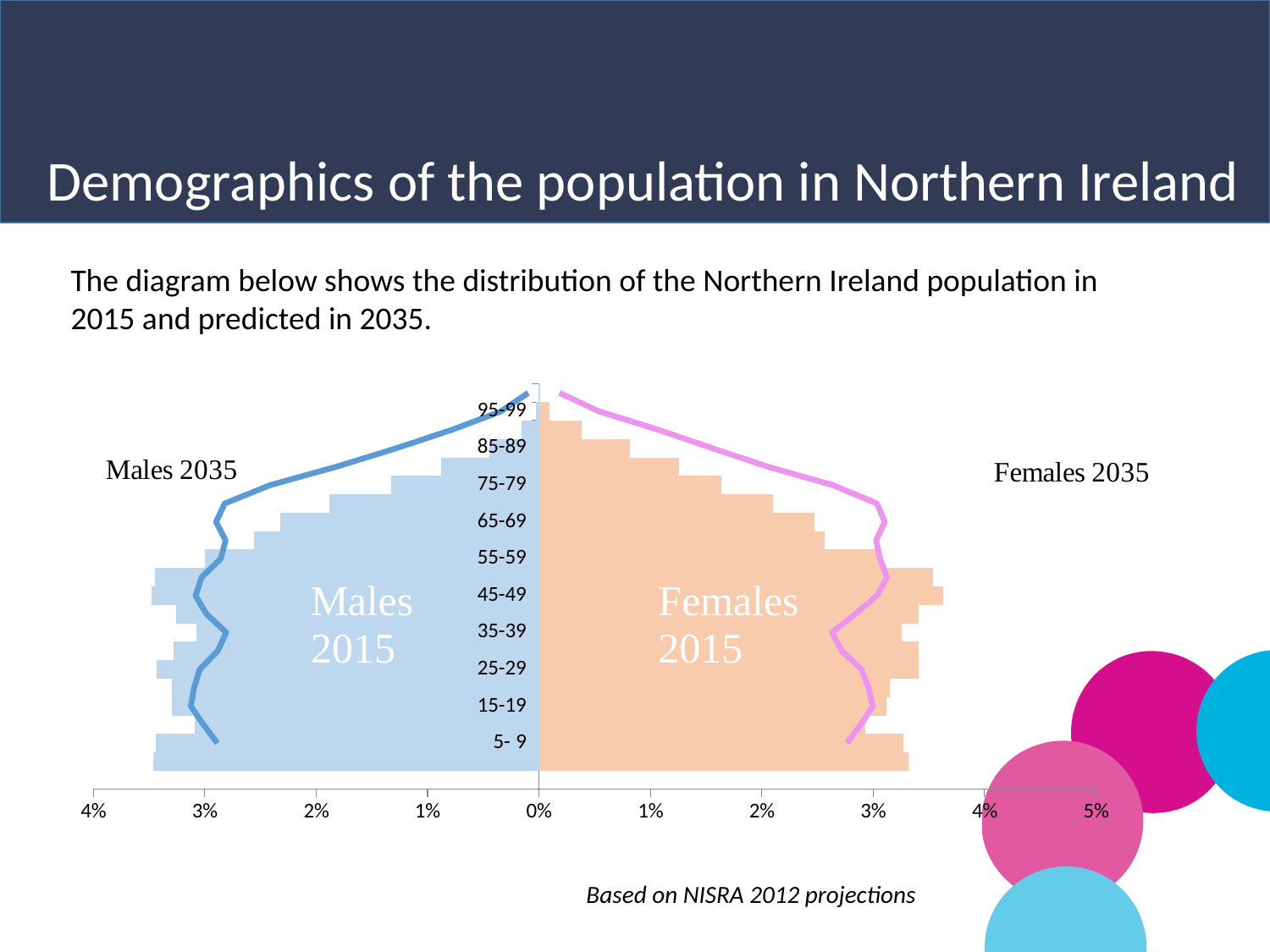
Is the Males 2015 value for the 45-49 age group greater or less than 3%? greater Is the Males 2015 value for the 85-89 age group greater or less than 1%? less What is the highest percentage tick shown on the right (female) side of the horizontal axis? 5% Is the Males 2015 value for the 65-69 age group greater or less than 2%? greater What kind of chart is shown on the slide? Bar chart (population pyramid) Which age group has the smallest Males 2015 share? 95-99 How many age-group labels are shown on the vertical axis of the chart? 10 For Males 2015, which is larger: the 45-49 age group or the 85-89 age group? 45-49 According to the note below the chart, what are the figures based on? NISRA 2012 projections How many data series are labelled on the chart? 4